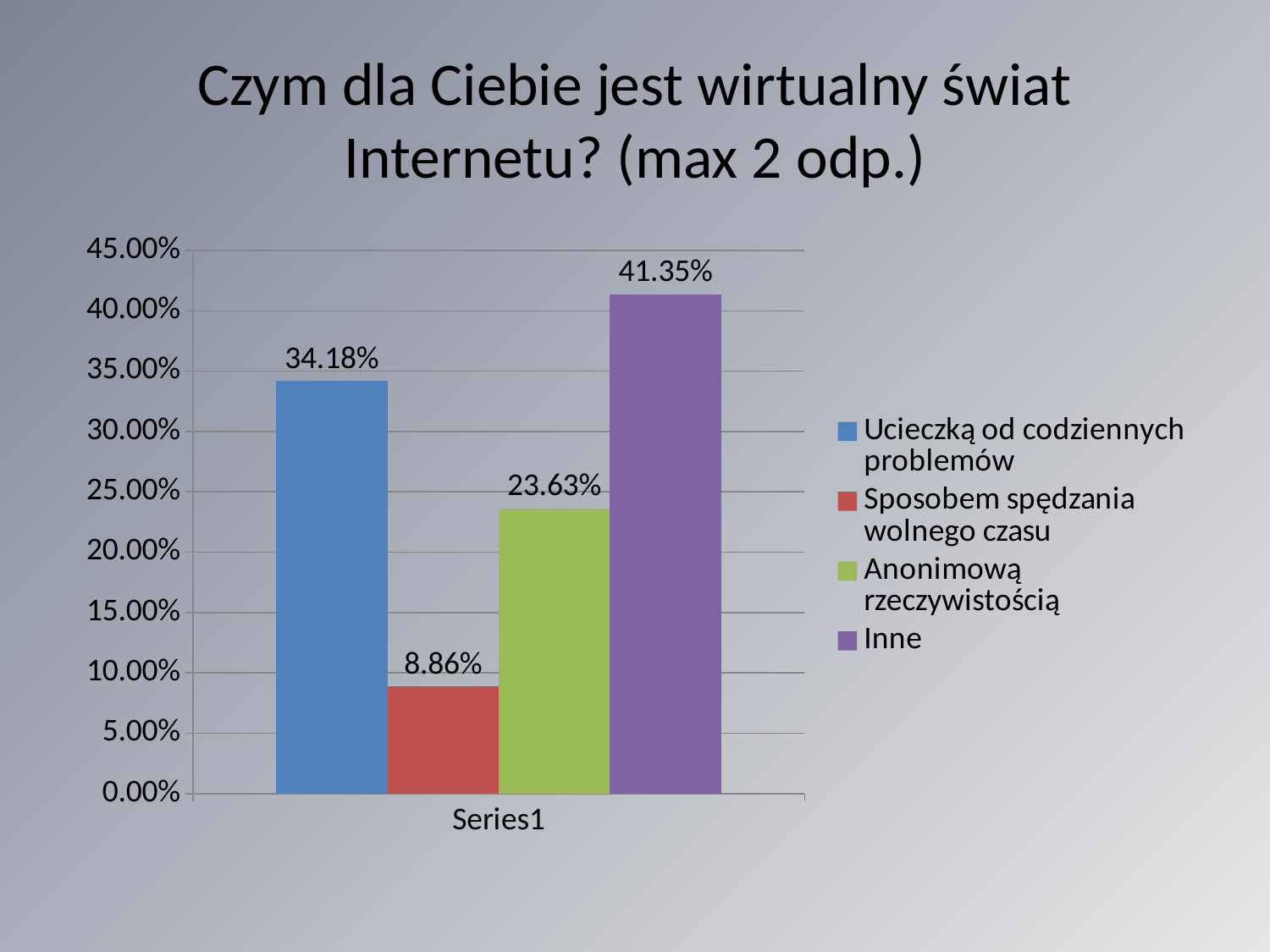
What value is shown for "Ucieczką od codziennych problemów"? 34.18% How many series does the legend list? 4 What kind of chart is shown on the slide? Bar chart Which is larger, the value for "Ucieczką od codziennych problemów" or the value for "Anonimową rzeczywistością"? Ucieczką od codziennych problemów Which legend entry has the lowest value? Sposobem spędzania wolnego czasu What is the title of the chart on the slide? Czym dla Ciebie jest wirtualny świat Internetu? (max 2 odp.) Which legend entry has the highest value? Inne What value is shown for "Sposobem spędzania wolnego czasu"? 8.86% What is the difference between the values for "Inne" and "Ucieczką od codziennych problemów"? 7.17% What value is shown for "Inne"? 41.35% What is the difference between the values for "Anonimową rzeczywistością" and "Sposobem spędzania wolnego czasu"? 14.77% What value is shown for "Anonimową rzeczywistością"? 23.63%